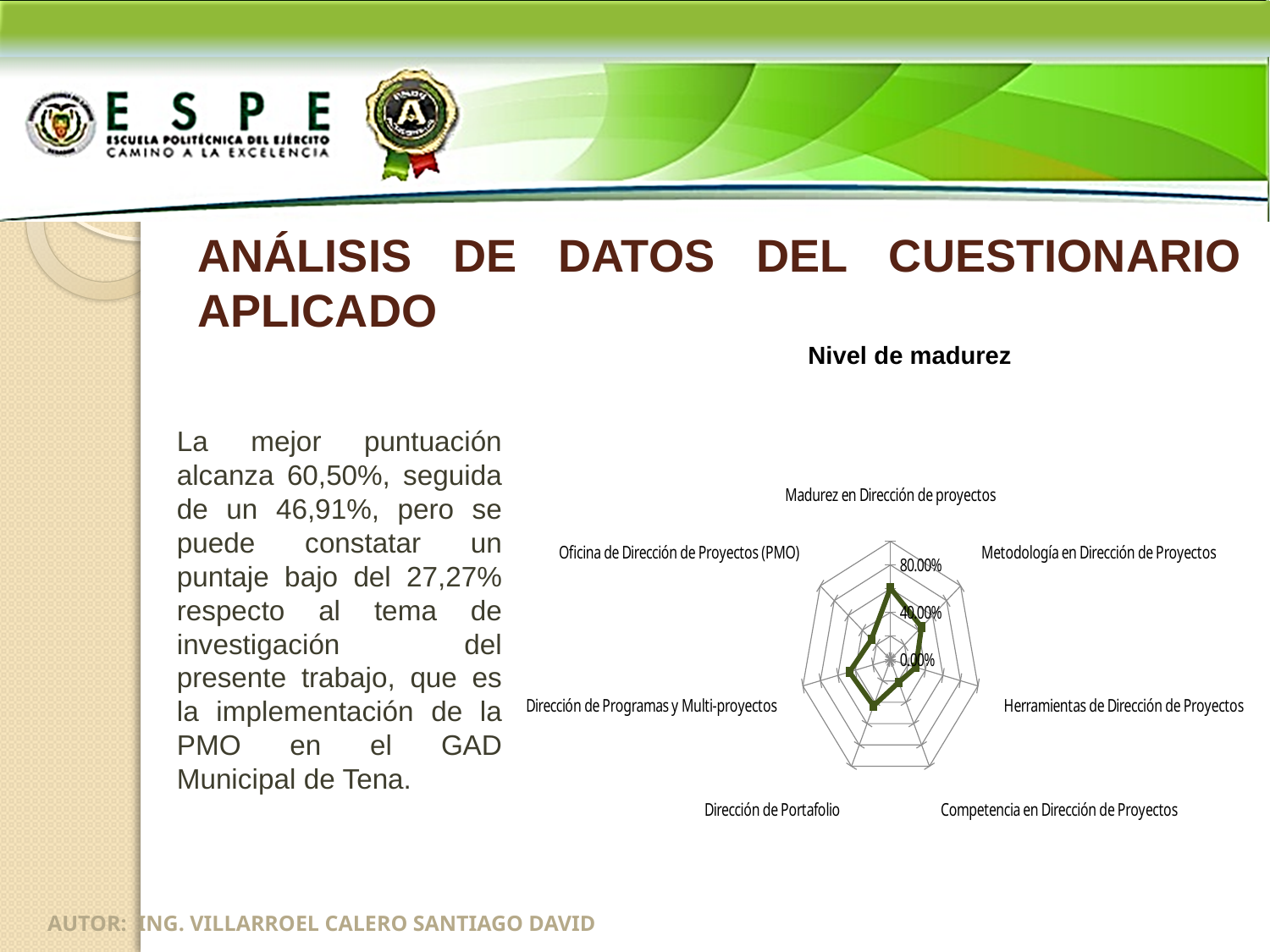
What is the title of the chart on the slide? Nivel de madurez Which is larger: the value for Dirección de Programas y Multi-proyectos or the value for Herramientas de Dirección de Proyectos? Dirección de Programas y Multi-proyectos What kind of chart is shown under the title 'Nivel de madurez'? Radar chart Which is larger: the value for Dirección de Programas y Multi-proyectos or the value for Competencia en Dirección de Proyectos? Dirección de Programas y Multi-proyectos What is the highest tick value shown on the radar chart's axis? 80.00% How many categories (axes) does the 'Nivel de madurez' radar chart have? 7 Is the value for Competencia en Dirección de Proyectos greater or less than 40.00%? less Is the value for Dirección de Programas y Multi-proyectos greater or less than 40.00%? greater Is the value for Dirección de Programas y Multi-proyectos greater or less than 80.00%? less Which category has the highest value in the 'Nivel de madurez' chart? Madurez en Dirección de proyectos